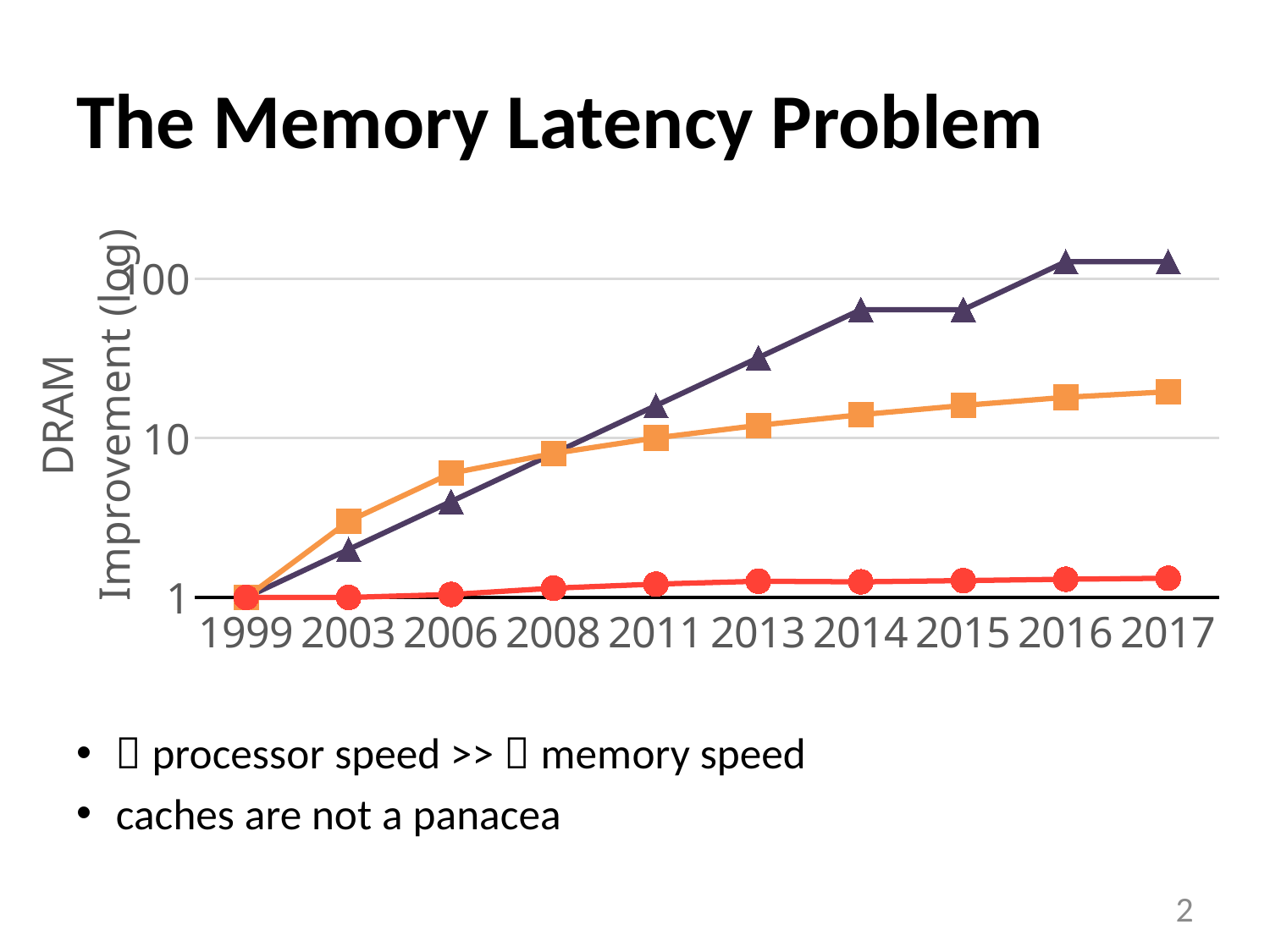
In 2003, which line has the higher value: the orange square line or the purple triangle line? the orange square line In 2017, which line has the higher value: the purple triangle line or the orange square line? the purple triangle line How many lines (series) are plotted on the chart? 3 Is the value of the orange square line in 2017 greater or less than 100? less Is the value of the purple triangle line in 2003 greater or less than 10? less Is the value of the red circle line in 2017 greater or less than 10? less What is the label on the y axis of the chart? Improvement (log) How many years are labelled along the x axis of the chart? 10 Does the purple triangle line generally rise or fall from 1999 to 2017? rise What kind of chart is shown on the slide? line chart